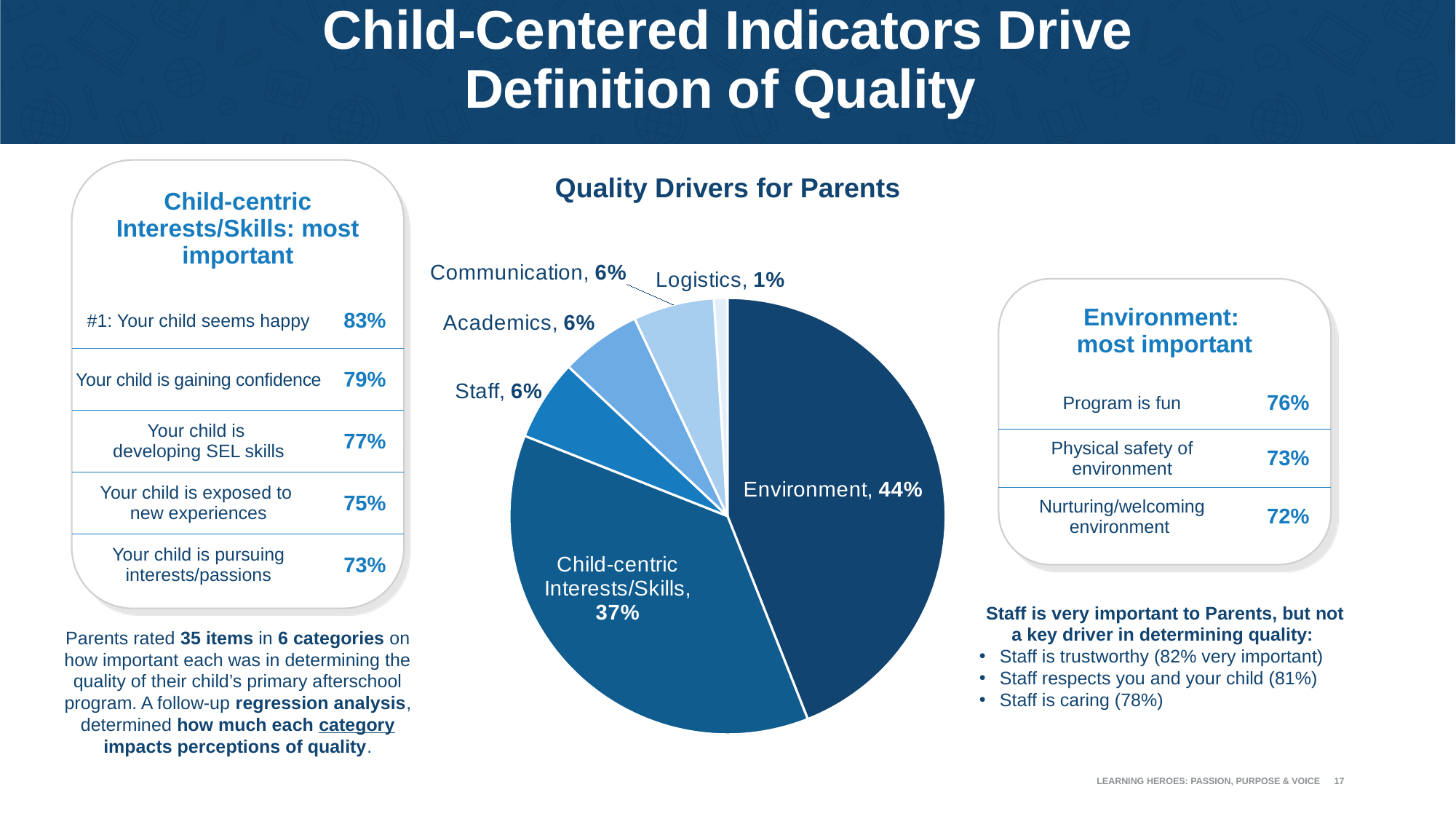
Which category has the smallest slice of the pie? Logistics Which is larger, the Academics slice or the Logistics slice? Academics What is the difference between the Environment and Child-centric Interests/Skills slices? 7% Which category has the largest slice of the pie? Environment What share of the pie does Environment account for? 44% What is the value for Logistics? 1% What is the title of the chart? Quality Drivers for Parents What is the combined share of Environment and Child-centric Interests/Skills? 81% What is the value for Child-centric Interests/Skills? 37% What is the value for Staff? 6% How many categories are shown in the pie chart? 6 What kind of chart is shown on the slide? pie chart